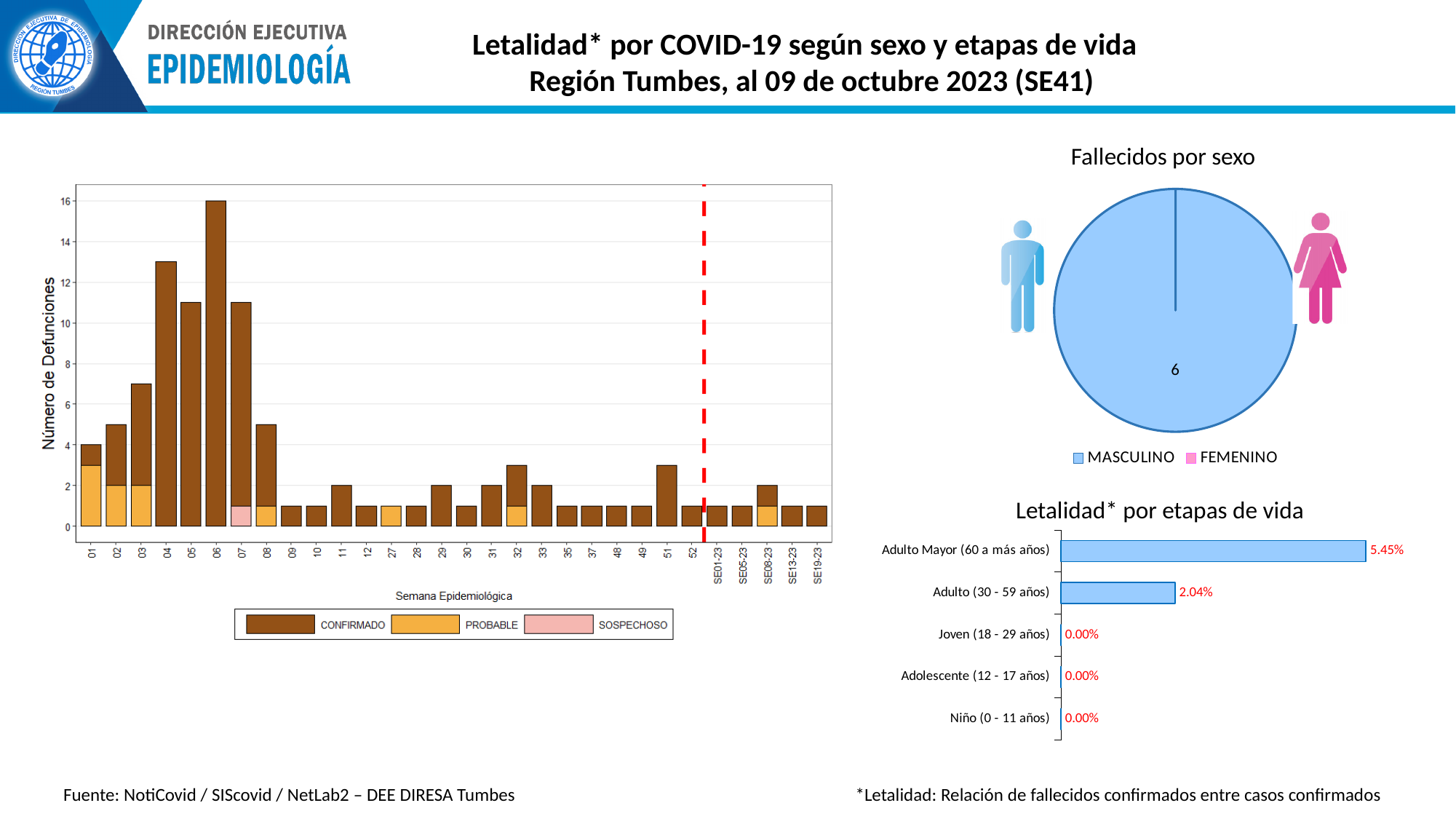
In the left chart of deaths by epidemiological week, what is the total number of deaths in week 06? 16 In the 'Letalidad* por etapas de vida' chart, what is the difference between Adulto Mayor (60 a más años) and Adulto (30 - 59 años)? 3.41% In the left chart of deaths by epidemiological week, is the value for week 03 greater or less than 8? less In the 'Fallecidos por sexo' pie chart, what value is shown for MASCULINO? 6 In the left chart of deaths by epidemiological week, how many series does the legend list? 3 In the 'Letalidad* por etapas de vida' chart, how many age-stage categories are shown? 5 In the left chart of deaths by epidemiological week, which is larger, the bar for week 04 or the bar for week 07? week 04 In the 'Letalidad* por etapas de vida' chart, what is the value for Adulto Mayor (60 a más años)? 5.45% In the left chart of deaths by epidemiological week, is the value for week 04 greater or less than 12? greater In the left chart of deaths by epidemiological week, which week has the highest number of deaths? 06 In the left chart of deaths by epidemiological week, what kind of chart is it? bar chart In the 'Fallecidos por sexo' pie chart, how many entries does the legend list? 2